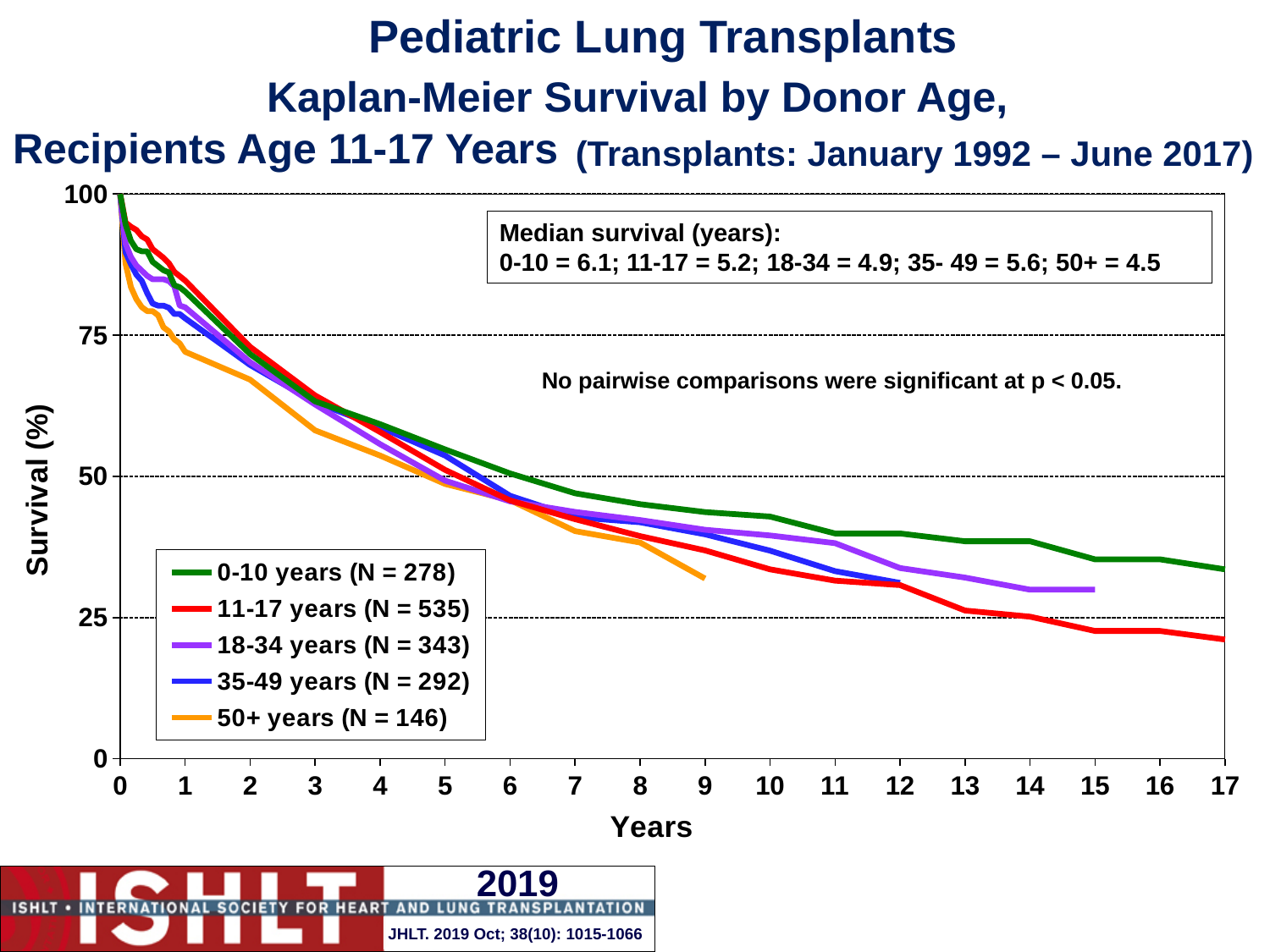
What is the median survival in years for the 0-10 years donor age group? 6.1 What is the median survival in years for the 50+ donor age group? 4.5 At 17 years, which line is higher: 0-10 years or 11-17 years? 0-10 years Which donor age group has the lowest median survival according to the text box? 50+ What is the difference in median survival between the 0-10 and 11-17 donor age groups? 0.9 years Is the survival value for the 0-10 years donor group at 17 years greater or less than 25? greater What kind of chart is shown on the slide? line chart Which donor age group has the highest median survival according to the text box? 0-10 Do the survival curves rise or fall as years increase? fall How many series does the legend list? 5 Is the survival value for the 11-17 years donor group at 17 years greater or less than 25? less What is the N for the 11-17 years donor group shown in the legend? 535